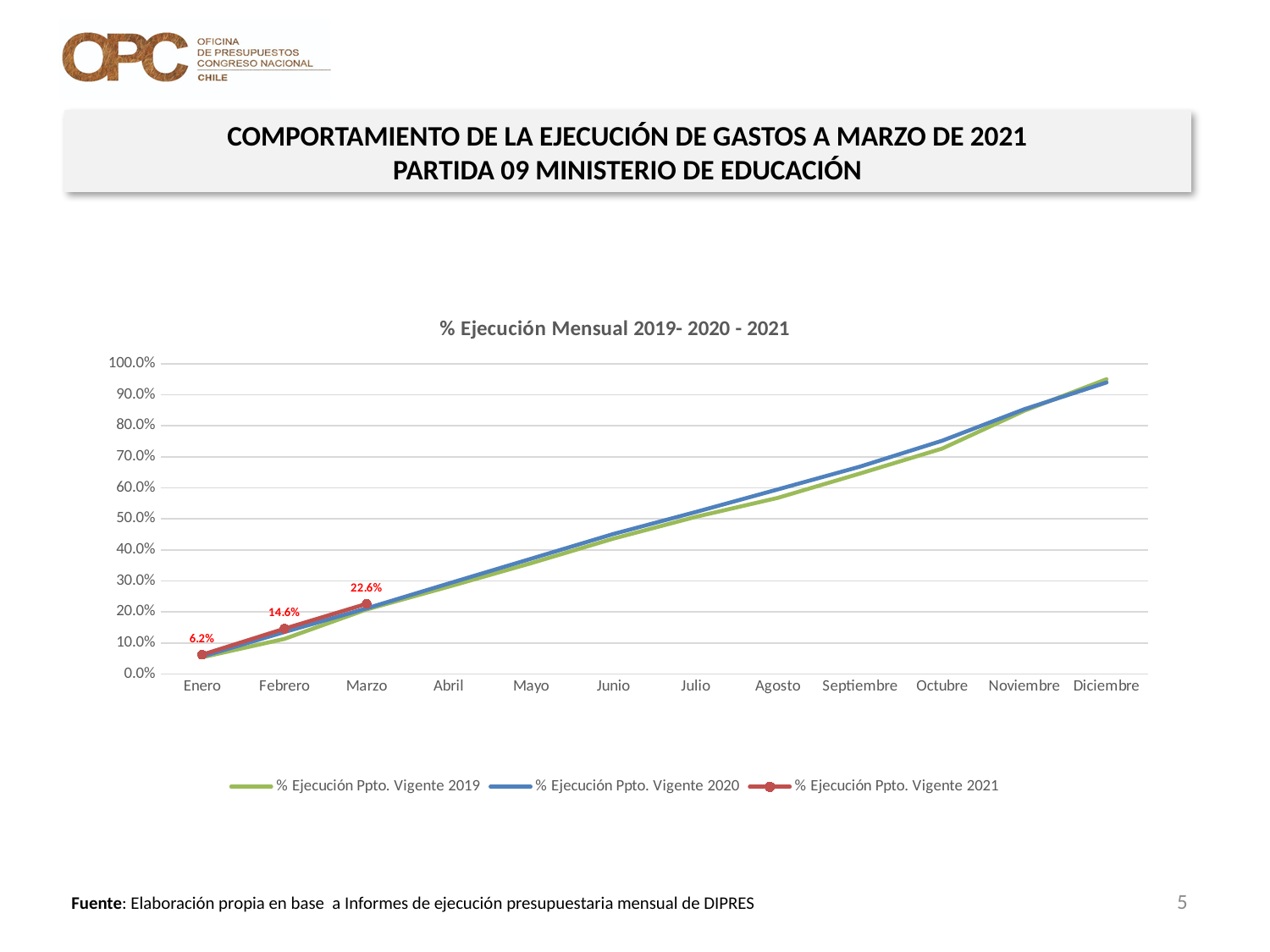
Is the value for % Ejecución Ppto. Vigente 2020 in Diciembre greater or less than 90%? greater What is the title of the chart? % Ejecución Mensual 2019- 2020 - 2021 Do the values for % Ejecución Ppto. Vigente 2019 rise or fall from Enero to Diciembre? Rise What is the difference between the 2021 values for Marzo and Febrero? 8.0% Which month has the highest value for % Ejecución Ppto. Vigente 2021? Marzo How many months are shown on the x axis? 12 What is the value of % Ejecución Ppto. Vigente 2021 for Marzo? 22.6% What is the difference between the 2021 values for Marzo and Enero? 16.4% What type of chart is shown on the slide? Line chart How many series does the legend list? 3 What is the value of % Ejecución Ppto. Vigente 2021 for Enero? 6.2% What is the value of % Ejecución Ppto. Vigente 2021 for Febrero? 14.6%